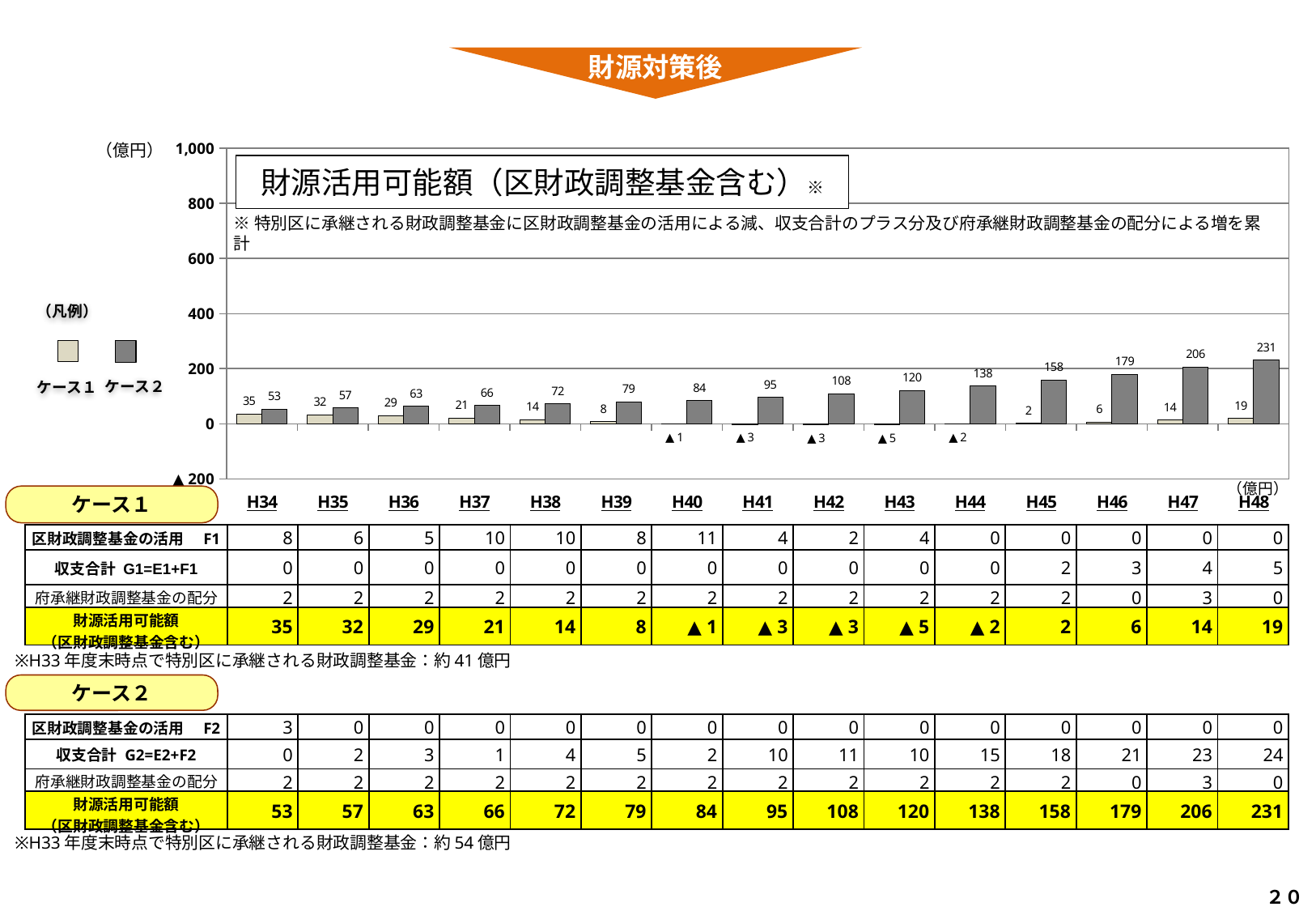
What kind of chart is shown on the slide? bar chart What is the difference between ケース2 and ケース1 in H47? 192 What is the value for ケース1 in H34? 35 Which is larger in H39, the value for ケース1 or ケース2? ケース2 Is the value for ケース2 in H48 greater or less than 200? greater Which year has the highest value for ケース2? H48 What is the value for ケース2 in H48? 231 What is the value for ケース1 in H43? ▲5 Which year has the lowest value for ケース1? H43 Do the values for ケース2 rise or fall from H34 to H48? rise How many series does the legend list? 2 How many years are shown on the x axis of the chart? 15